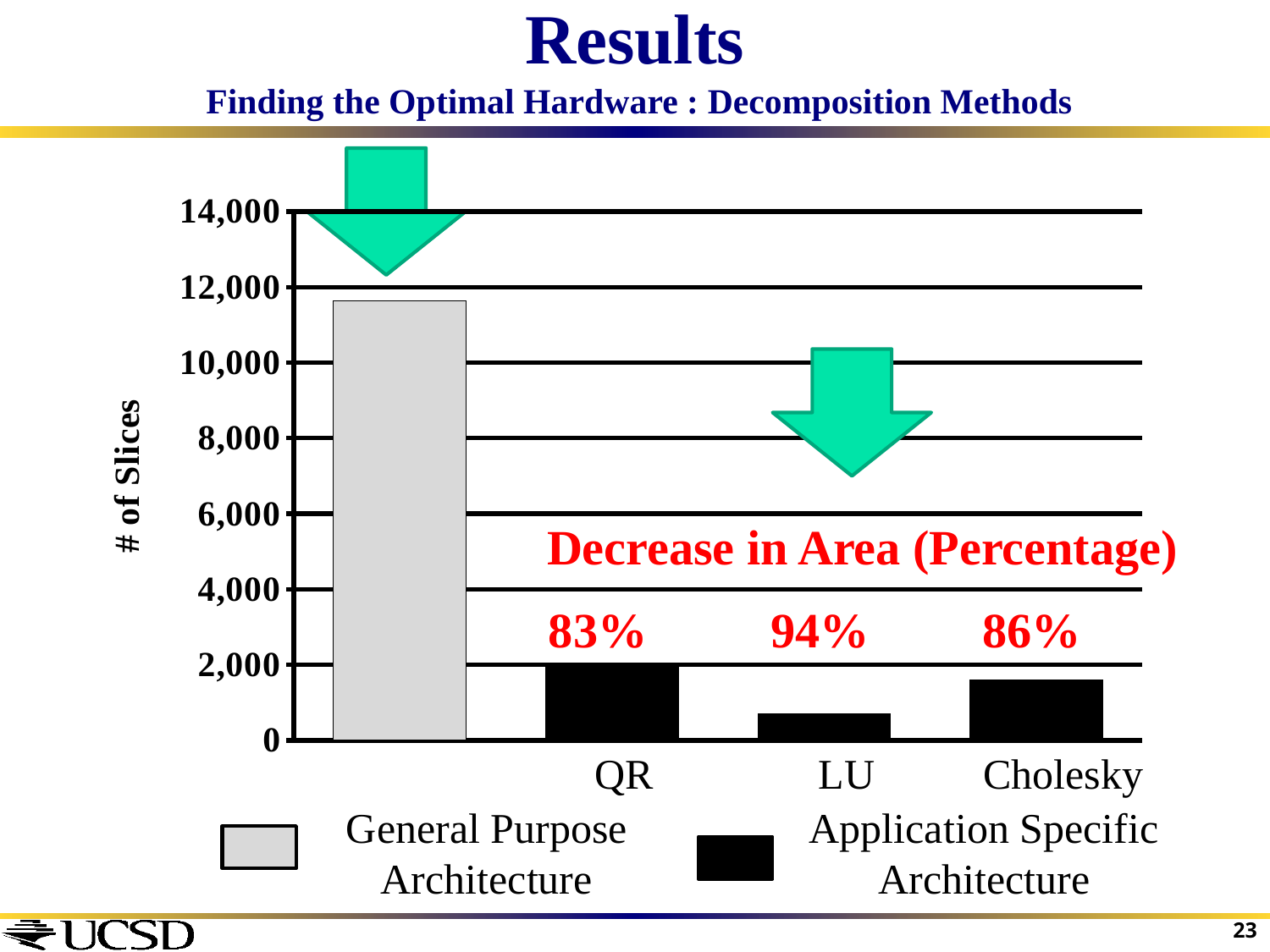
How many series does the legend list? 2 Is the number of slices for QR greater or less than 4,000? less Is the number of slices for LU greater or less than 2,000? less Is the number of slices for the General Purpose Architecture greater or less than 10,000? greater Which bar has the highest number of slices? General Purpose Architecture Which has more slices, QR or LU? QR What kind of chart is shown on the slide? bar chart What is the decrease in area (percentage) shown for Cholesky? 86% Which of the application-specific architectures (QR, LU, Cholesky) has the lowest number of slices? LU What is the decrease in area (percentage) shown for LU? 94% What is the label of the y-axis? # of Slices How many bars are plotted in the chart? 4